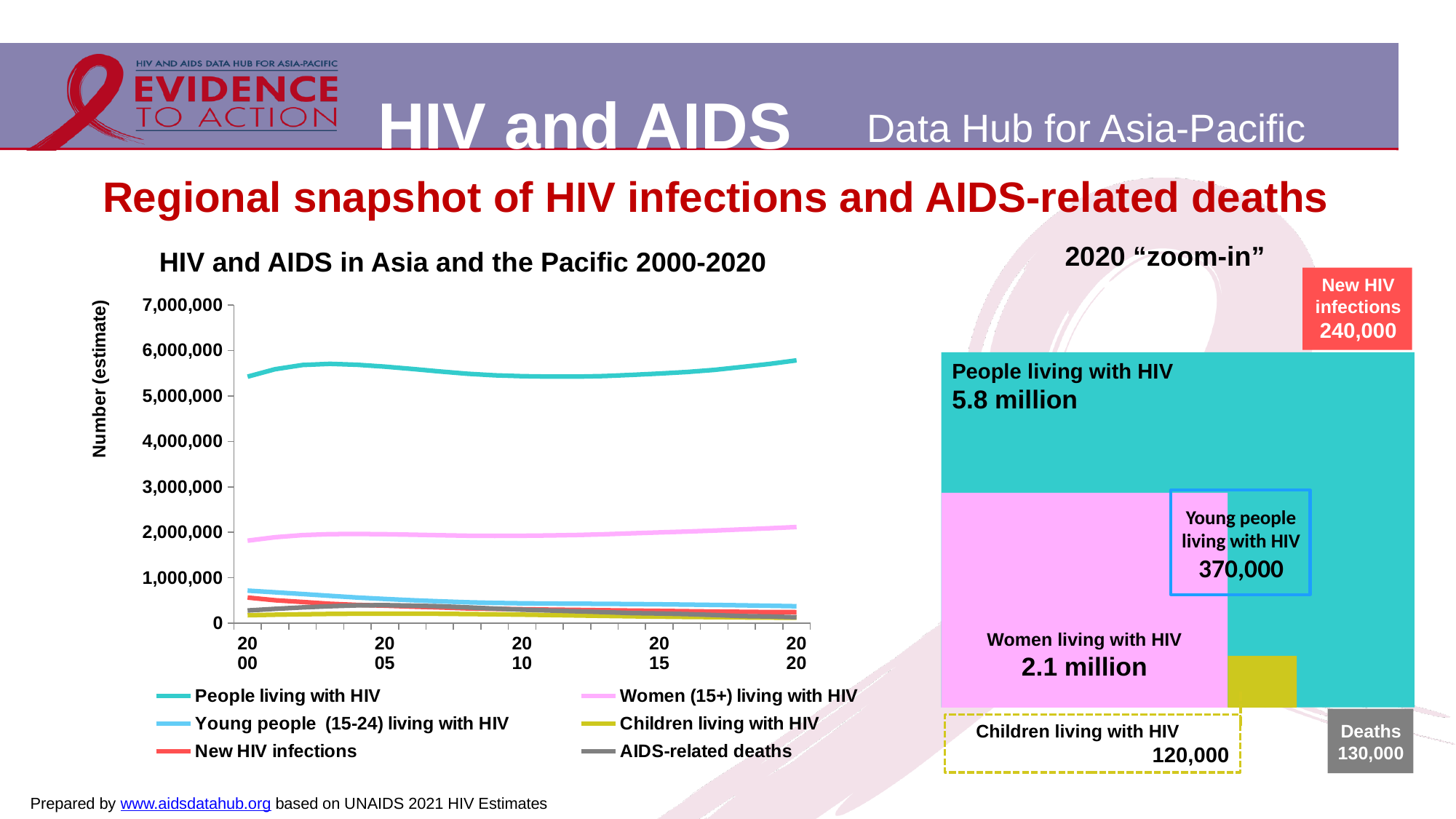
In the "HIV and AIDS in Asia and the Pacific 2000-2020" chart, what is the title of the vertical axis? Number (estimate) In the "HIV and AIDS in Asia and the Pacific 2000-2020" chart, is the value for People living with HIV in 2020 greater or less than 5,000,000? greater In the "HIV and AIDS in Asia and the Pacific 2000-2020" chart, is the value for Women (15+) living with HIV in 2000 greater or less than 2,000,000? less What kind of chart is "HIV and AIDS in Asia and the Pacific 2000-2020"? Line chart How many series does the legend of the "HIV and AIDS in Asia and the Pacific 2000-2020" chart list? 6 In the "HIV and AIDS in Asia and the Pacific 2000-2020" chart, which is larger in 2000: Young people (15-24) living with HIV or New HIV infections? Young people (15-24) living with HIV In the 2020 "zoom-in" graphic, which is larger: Children living with HIV or Deaths? Deaths In the 2020 "zoom-in" graphic, how many people are living with HIV? 5.8 million In the 2020 "zoom-in" graphic, how many young people are living with HIV? 370,000 In the 2020 "zoom-in" graphic, what is the difference between New HIV infections and Deaths? 110,000 In the "HIV and AIDS in Asia and the Pacific 2000-2020" chart, does the Women (15+) living with HIV line rise or fall from 2000 to 2020? Rise In the "HIV and AIDS in Asia and the Pacific 2000-2020" chart, which series has the highest values throughout the period? People living with HIV